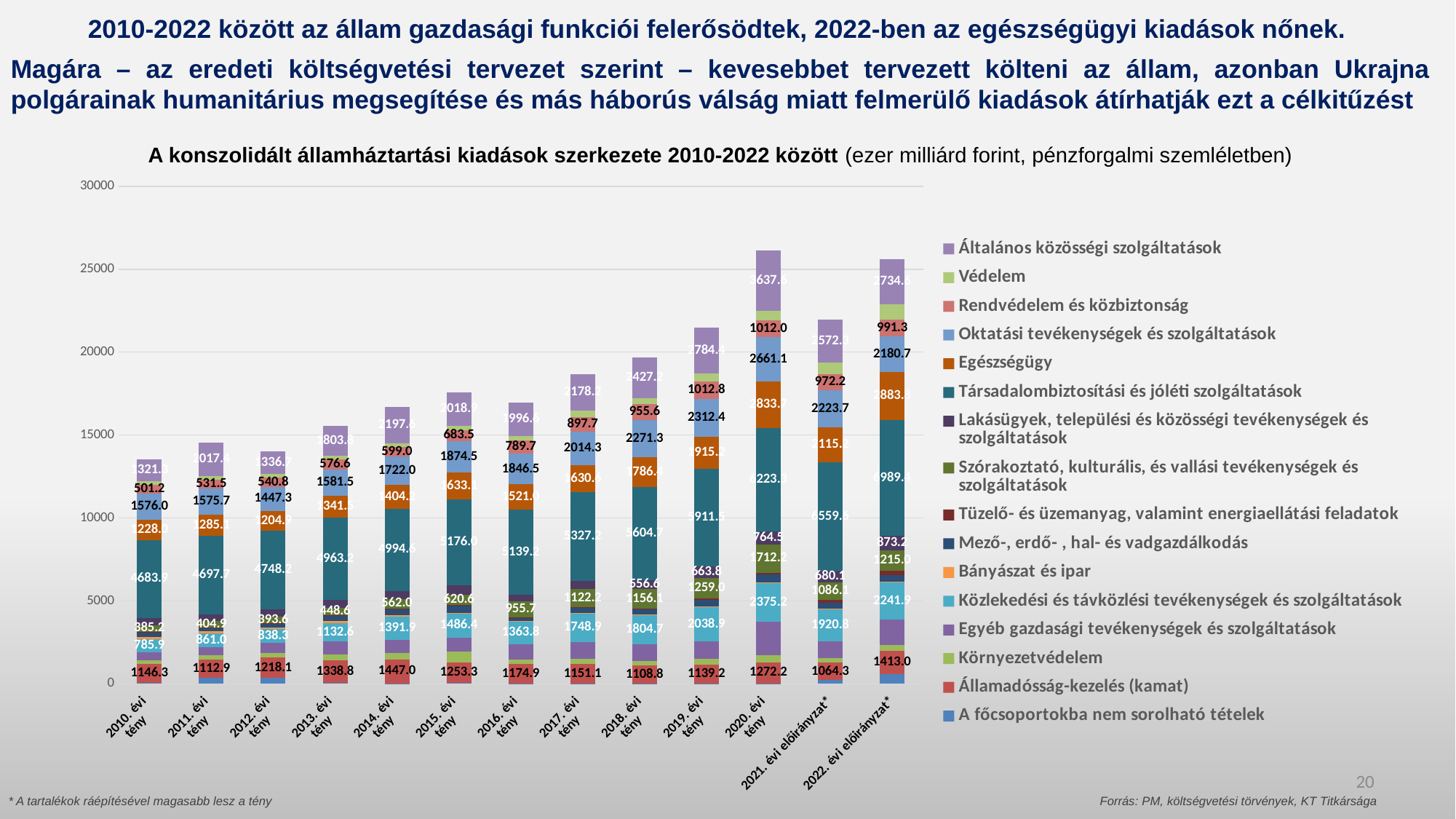
What is the value of Általános közösségi szolgáltatások for 2020. évi tény? 3637.6 By how much does Társadalombiztosítási és jóléti szolgáltatások in 2022. évi előirányzat* exceed its 2010. évi tény value? 2305.5 Which year has the tallest stacked bar (highest total expenditure)? 2020. évi tény How many years (categories) are shown along the x axis? 13 What kind of chart is shown on the slide? Stacked bar chart What is the value of Egészségügy for 2022. évi előirányzat*? 2883.8 Is the total of the 2010. évi tény bar greater or less than 15000? less How many series does the legend list? 16 Which is larger, Oktatási tevékenységek és szolgáltatások in 2020. évi tény or in 2022. évi előirányzat*? 2020. évi tény What is the value of Államadósság-kezelés (kamat) for 2020. évi tény? 1272.2 What is the value of Társadalombiztosítási és jóléti szolgáltatások for 2010. évi tény? 4683.9 What is the value of Társadalombiztosítási és jóléti szolgáltatások for 2022. évi előirányzat*? 6989.4